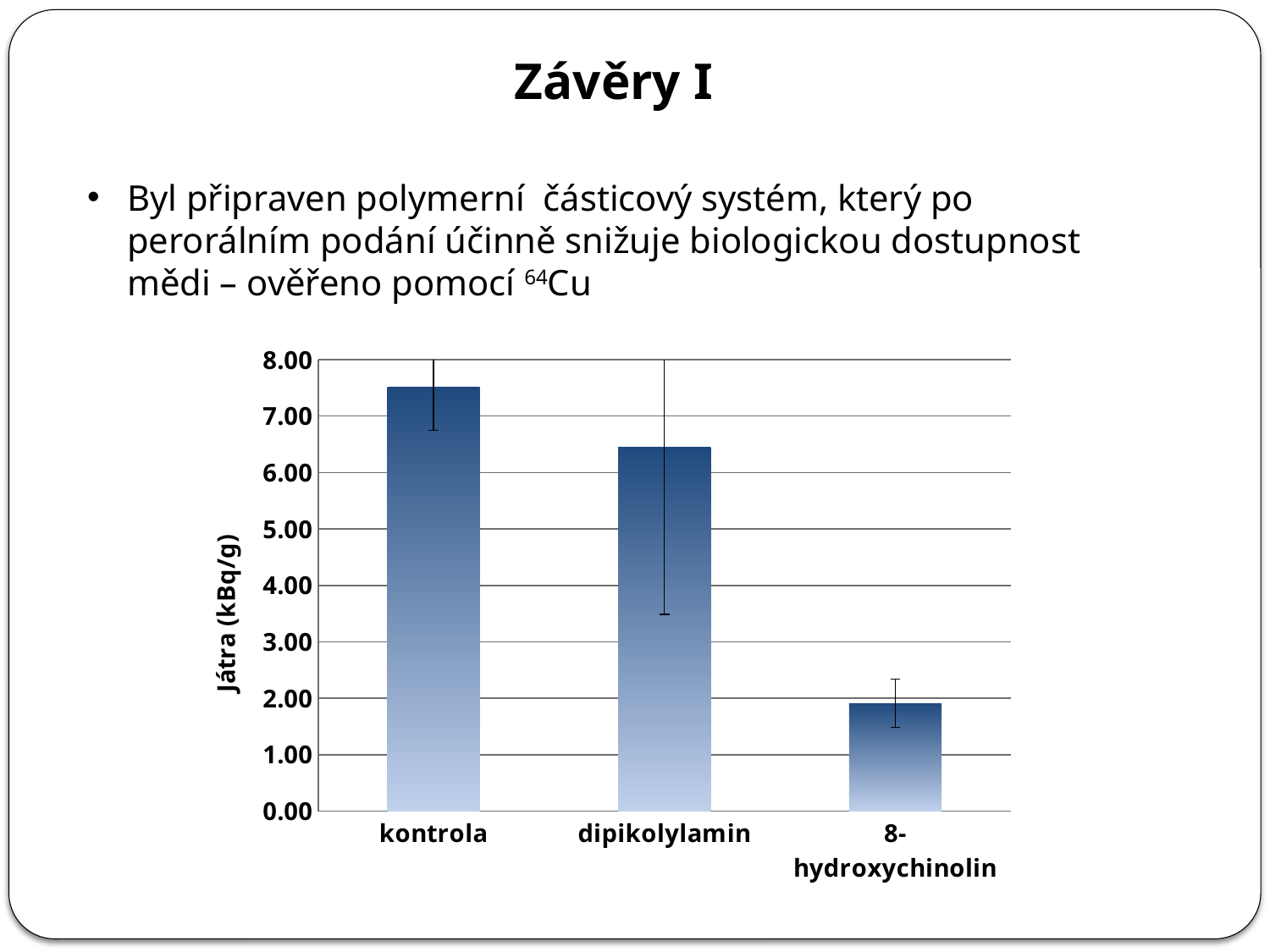
How many categories are shown on the x axis of the chart? 3 What kind of chart is shown on the slide? bar chart Which category has the lowest value in the chart? 8-hydroxychinolin What is the label of the vertical axis of the chart? Játra (kBq/g) Is the value for dipikolylamin greater or less than 6.00? greater Which is larger, the value for kontrola or the value for dipikolylamin? kontrola Which is larger, the value for dipikolylamin or the value for 8-hydroxychinolin? dipikolylamin Is the value for kontrola greater or less than 7.00? greater Which category has the highest value in the chart? kontrola Is the value for dipikolylamin greater or less than 7.00? less Do the bar values rise or fall from left to right across the x axis? fall